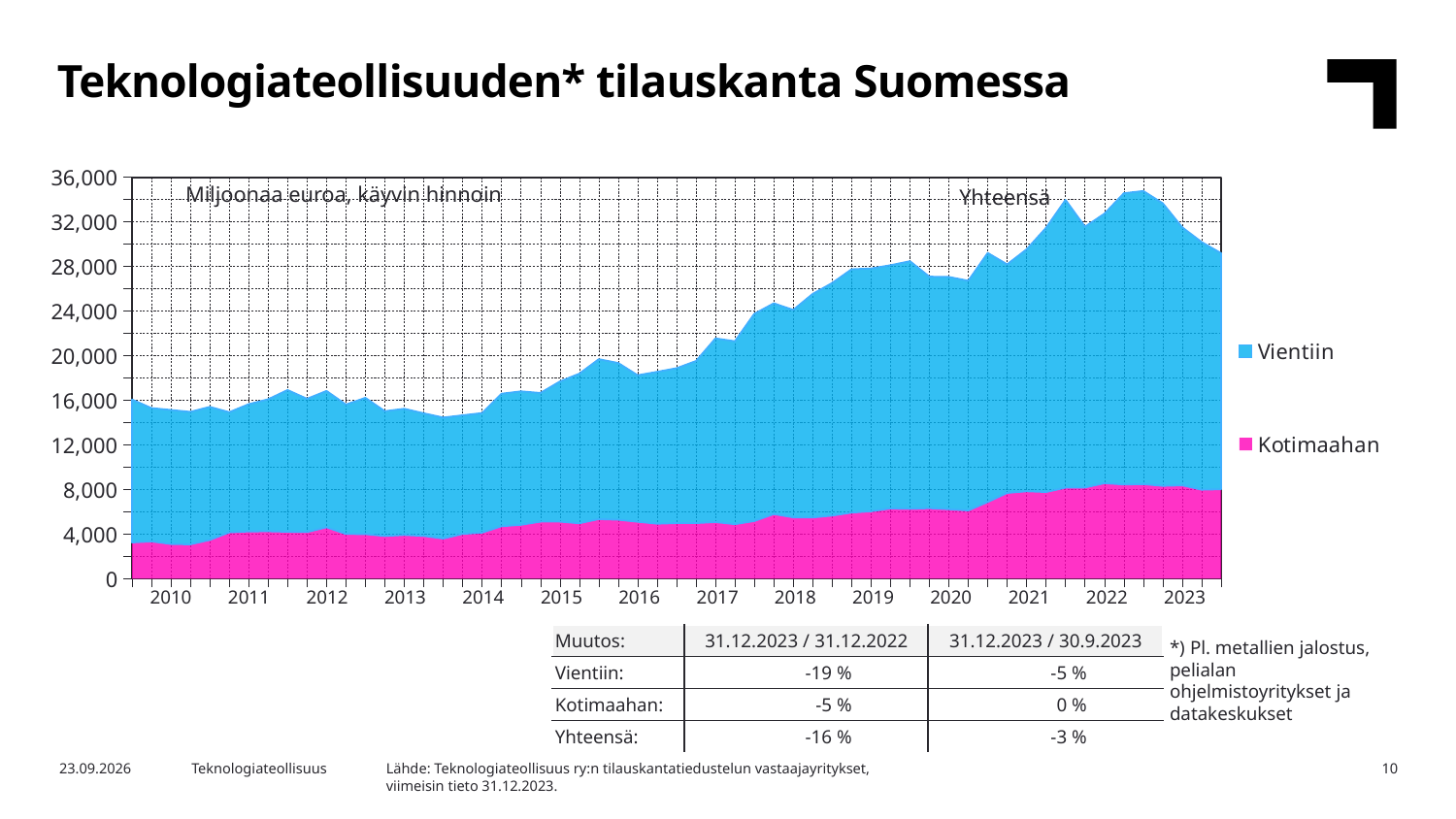
Is the Kotimaahan value in 2022 greater or less than 4,000? greater Which series is larger throughout the chart, Vientiin or Kotimaahan? Vientiin What is the title of the chart on the slide? Teknologiateollisuuden* tilauskanta Suomessa Is the peak total (Yhteensä) value in 2022 greater or less than 32,000? greater According to the table below the chart, what is the change in Yhteensä between 31.12.2022 and 31.12.2023? -16 % What are the two series named in the chart legend? Vientiin and Kotimaahan Does the total order book (Yhteensä) generally rise or fall from 2010 to 2022? rise What kind of chart is shown on the slide? Stacked area chart How many years are labelled on the x axis of the chart? 14 Is the total (Yhteensä) value at the start of 2010 greater or less than 20,000? less How many series does the chart legend list? 2